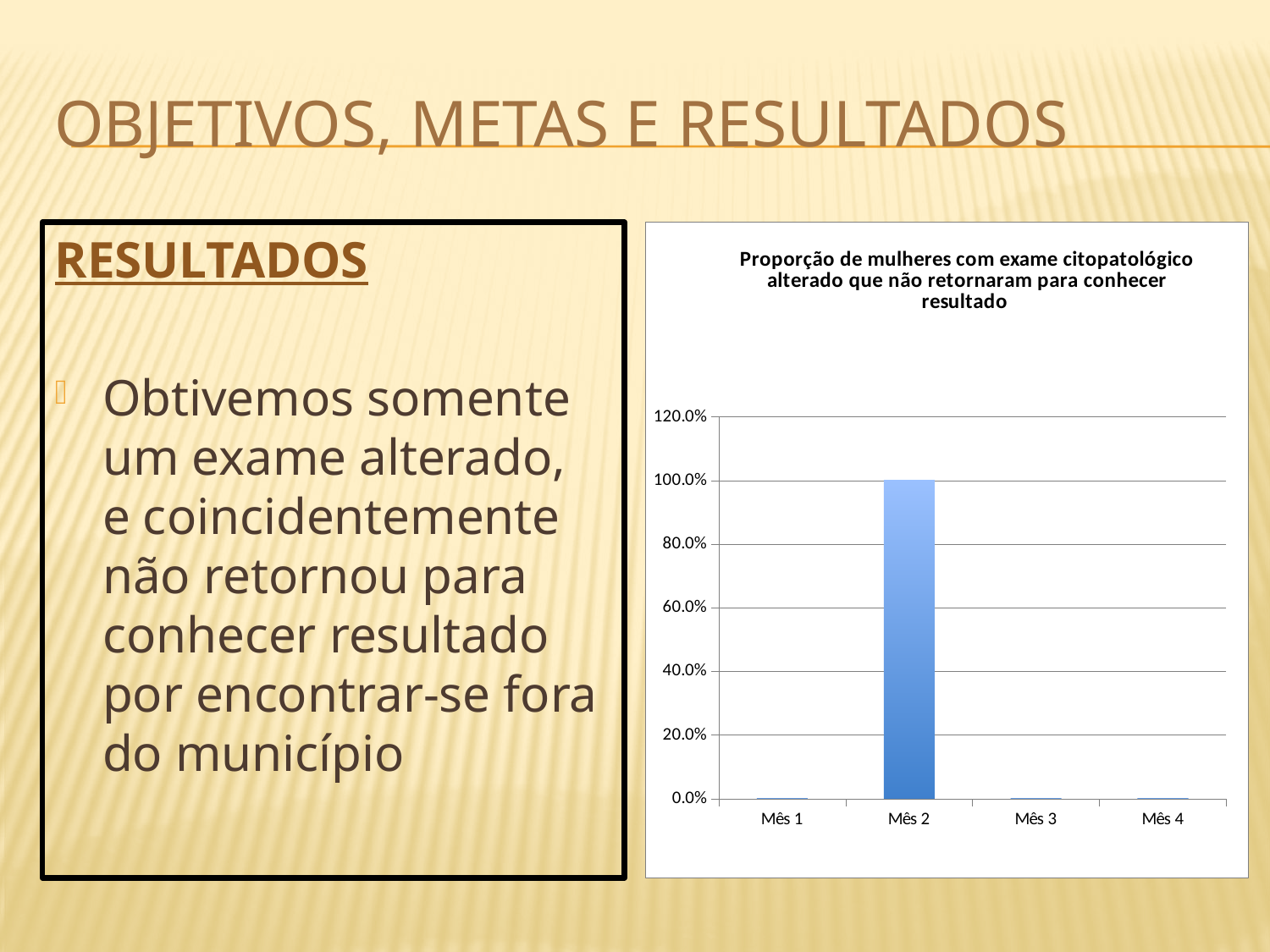
How many categories are shown on the x axis of the chart? 4 What is the value for Mês 4? 0.0% What is the value for Mês 1? 0.0% What is the difference between the values for Mês 2 and Mês 1? 100.0% Is the value for Mês 3 greater or less than 20.0%? less Which is larger, the value for Mês 2 or the value for Mês 3? Mês 2 Which month has the highest value in the chart? Mês 2 What is the title of the chart? Proporção de mulheres com exame citopatológico alterado que não retornaram para conhecer resultado What is the highest value shown on the y axis of the chart? 120.0% What is the value for Mês 2? 100.0% What kind of chart is shown on the slide? bar chart Is the value for Mês 2 greater or less than 80.0%? greater